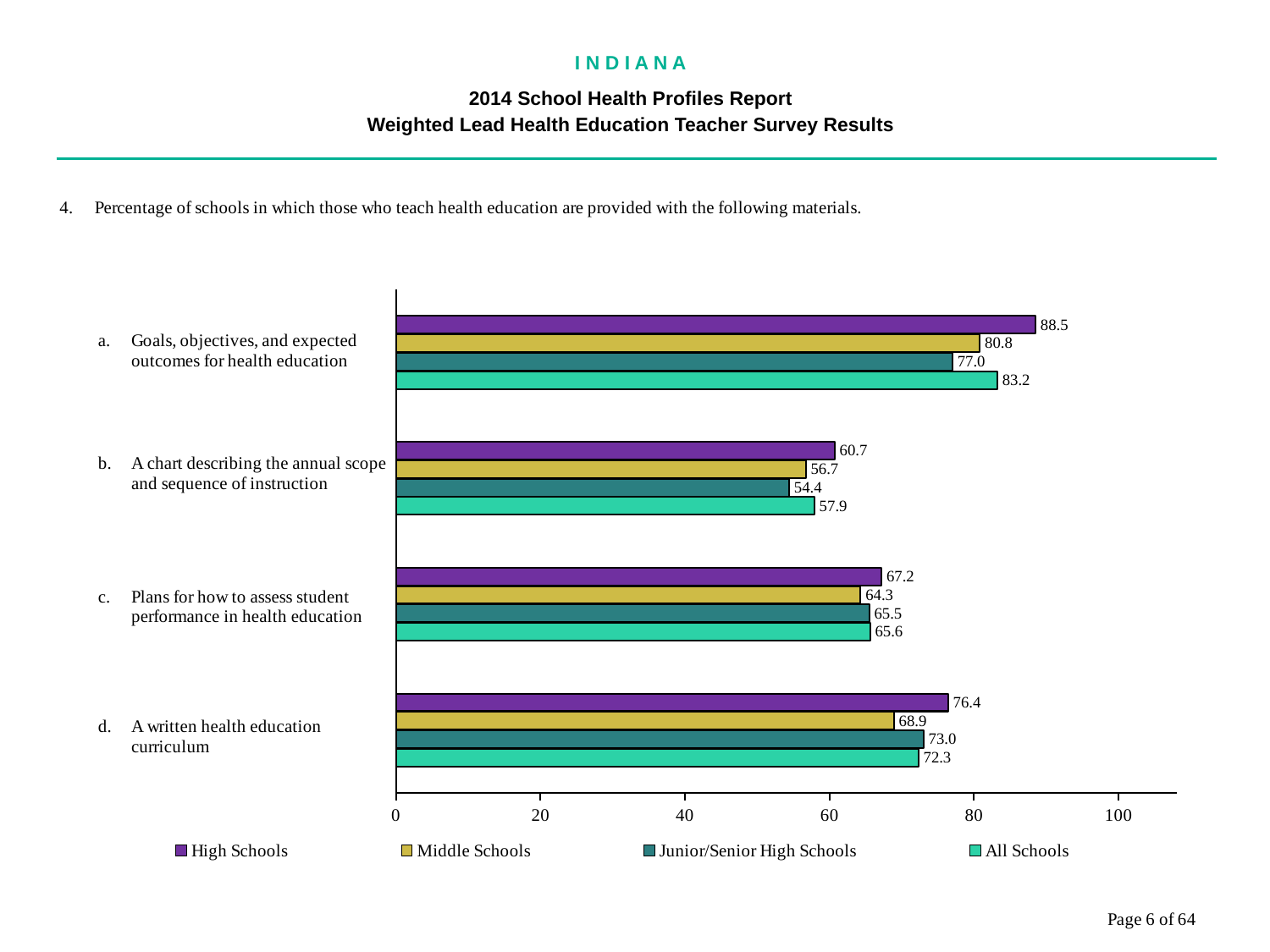
How many categories (materials) are shown in the chart? 4 How many series does the legend list? 4 What is the difference between the High Schools and Middle Schools values for 'A written health education curriculum'? 7.5 Which category has the highest value for High Schools? Goals, objectives, and expected outcomes for health education Which category has the lowest value for All Schools? A chart describing the annual scope and sequence of instruction Which series is shown in purple in the legend? High Schools What is the value for High Schools for 'Goals, objectives, and expected outcomes for health education'? 88.5 What is the value for Junior/Senior High Schools for 'A chart describing the annual scope and sequence of instruction'? 54.4 What kind of chart is shown on the slide? Bar chart Which is larger for 'Goals, objectives, and expected outcomes for health education': the Middle Schools value or the Junior/Senior High Schools value? Middle Schools What is the value for Middle Schools for 'A written health education curriculum'? 68.9 What is the value for All Schools for 'Plans for how to assess student performance in health education'? 65.6